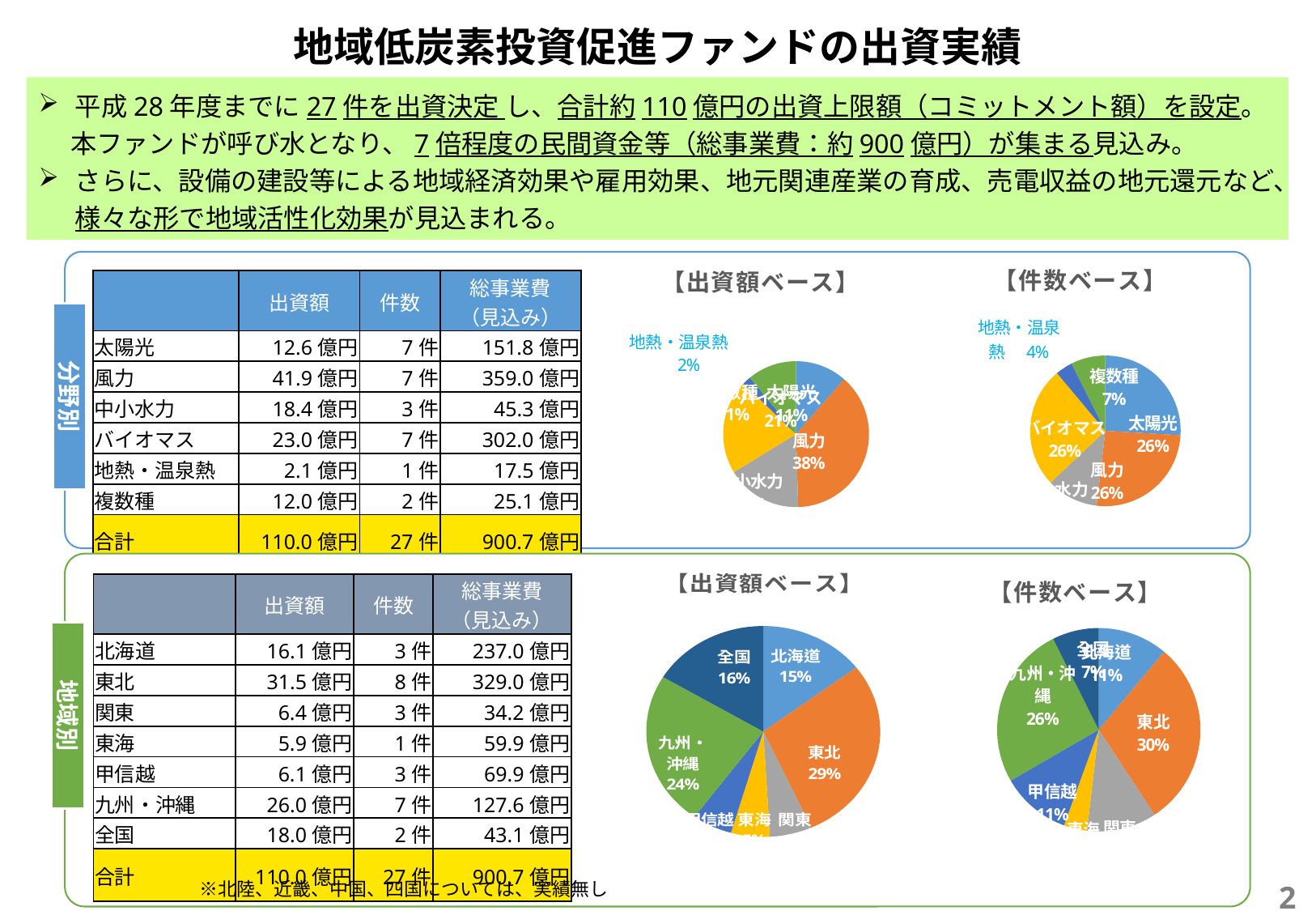
In the 地域別 【出資額ベース】 pie chart, what is the difference between the shares of 全国 and 北海道? 1% In the 分野別 【件数ベース】 pie chart, what is the difference between the shares of 太陽光 and 複数種? 19% In the 地域別 【出資額ベース】 pie chart, what share does 東北 have? 29% In the 分野別 【出資額ベース】 pie chart, what share does 地熱・温泉熱 have? 2% In the 分野別 【件数ベース】 pie chart, what share does 複数種 have? 7% In the 分野別 【出資額ベース】 pie chart, which category has the largest slice? 風力 In the 分野別 【出資額ベース】 pie chart, what share does 風力 have? 38% In the 地域別 【出資額ベース】 pie chart, which is larger, 九州・沖縄 or 北海道? 九州・沖縄 In the 分野別 【件数ベース】 pie chart, what share does 地熱・温泉熱 have? 4% What kind of chart is the 【出資額ベース】 chart in the 分野別 section? pie chart In the 地域別 【件数ベース】 pie chart, what share does 東北 have? 30% In the 地域別 【件数ベース】 pie chart, what share does 甲信越 have? 11%